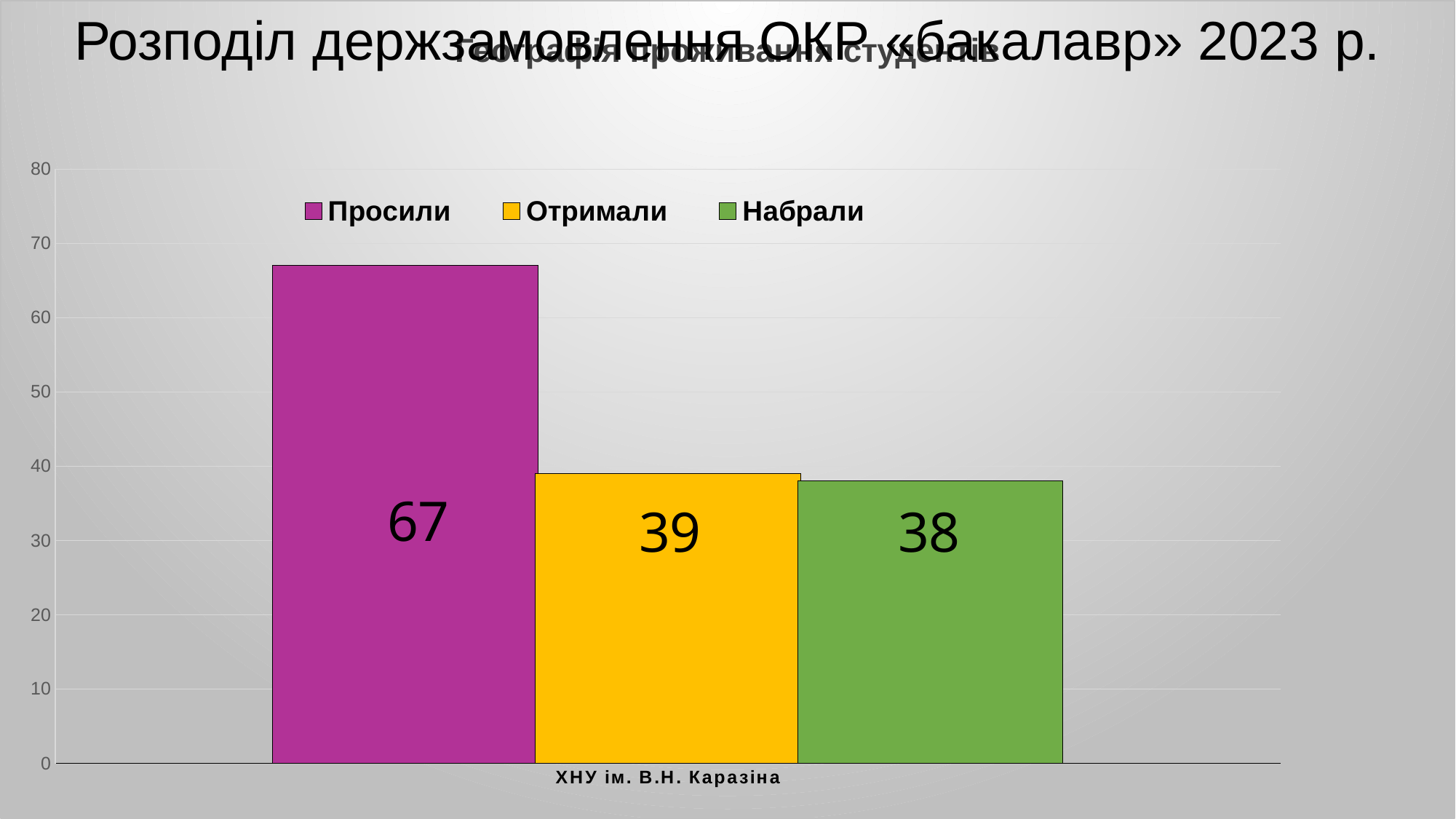
What is the difference between Просили and Отримали? 28 Is the value for Просили greater or less than 60? greater What is the value for Набрали? 38 What is the value for Отримали? 39 How many series does the legend list? 3 Which is larger, Просили or Набрали? Просили What is the value for Просили? 67 Which series has the lowest value? Набрали What kind of chart is shown on the slide? bar chart What colour is the bar for Отримали? yellow What is the difference between Отримали and Набрали? 1 Which series has the highest value? Просили